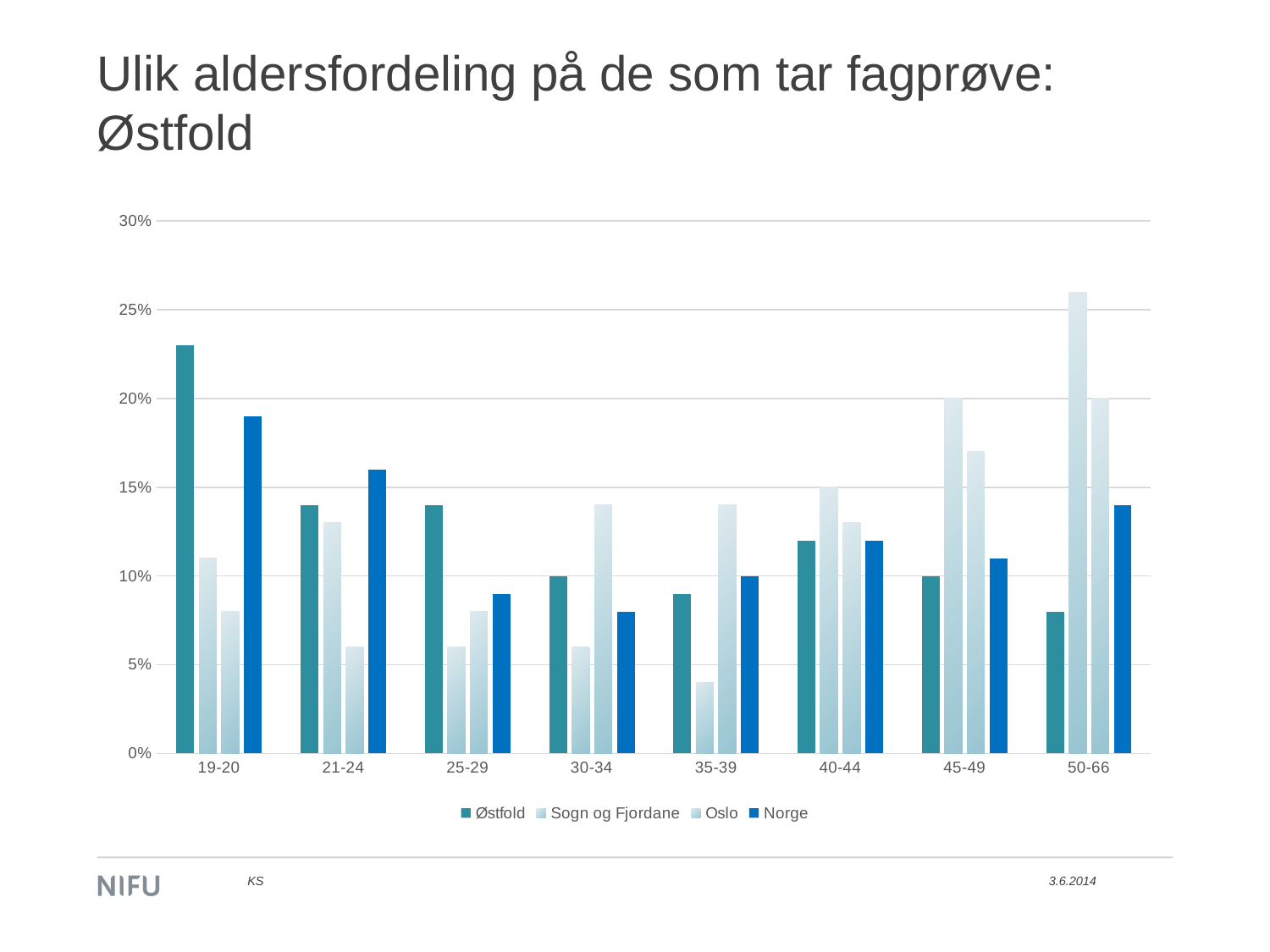
In the 45-49 age group, which is larger: Sogn og Fjordane or Østfold? Sogn og Fjordane How many series does the legend list? 4 Is the value for Østfold in the 19-20 age group greater or less than 20%? greater Which age group has the highest bar for Sogn og Fjordane? 50-66 Is the value for Sogn og Fjordane in the 50-66 age group greater or less than 25%? greater How many age groups are shown on the x axis? 8 Which age group has the lowest bar for Sogn og Fjordane? 35-39 Which series does the legend list first? Østfold In the 19-20 age group, which is larger: Østfold or Norge? Østfold Is the value for Sogn og Fjordane in the 35-39 age group greater or less than 5%? less Which age group has the highest bar for Østfold? 19-20 What kind of chart is shown on the slide? bar chart